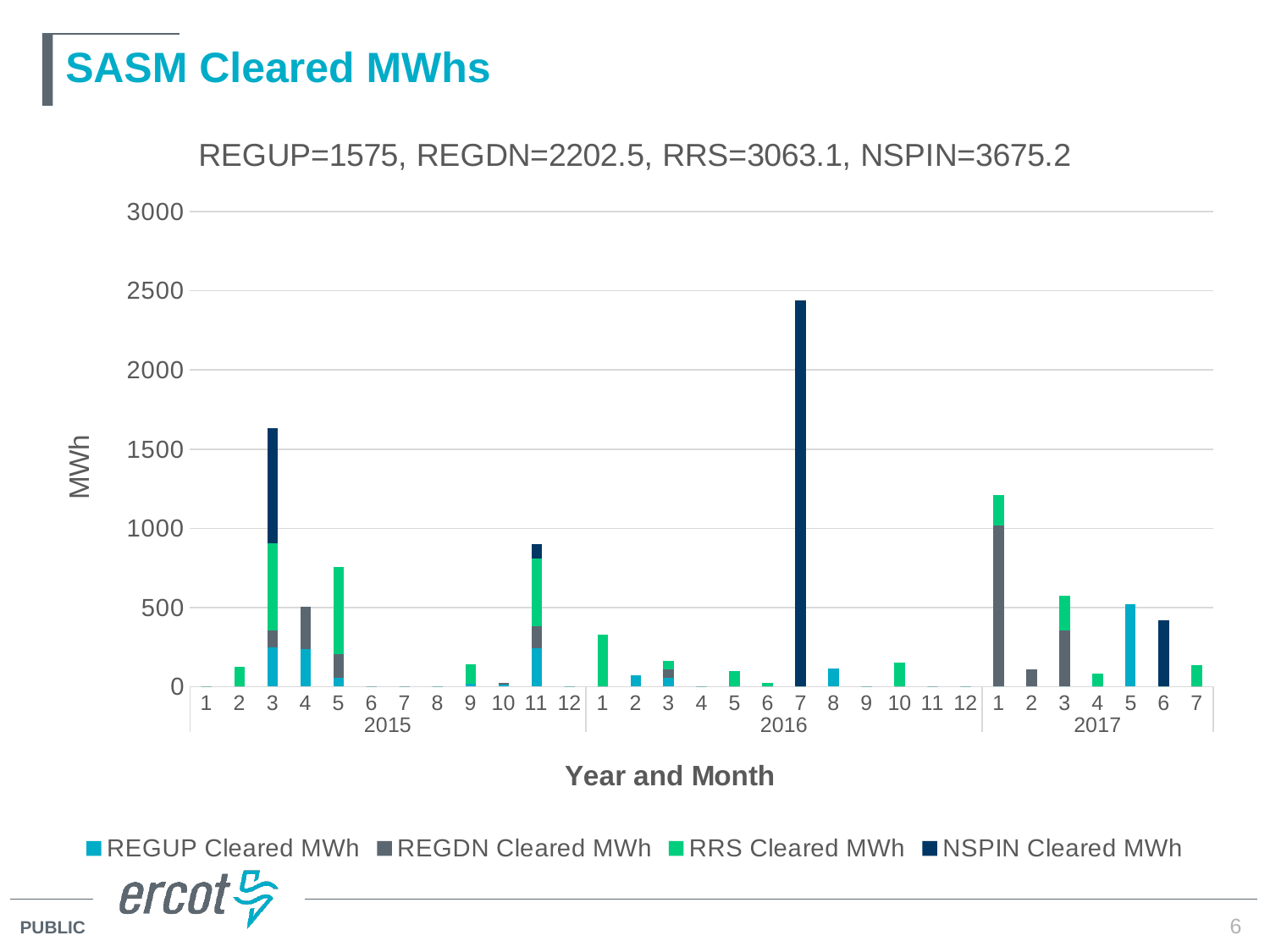
According to the subtitle, what is the total NSPIN cleared MWh? 3675.2 What kind of chart is shown on the slide? Stacked bar chart What is the label on the y axis? MWh Is the value for month 7 of 2016 greater or less than 2000? greater How many series does the legend list? 4 Which year and month has the tallest bar? 2016, month 7 Is the total bar for month 1 of 2016 greater or less than 500? less Is the total bar for month 1 of 2017 greater or less than 1000? greater According to the subtitle, which series has the largest total cleared MWh? NSPIN Which bar is taller: month 3 of 2015 or month 1 of 2017? Month 3 of 2015 How many year-month categories are shown along the x axis? 31